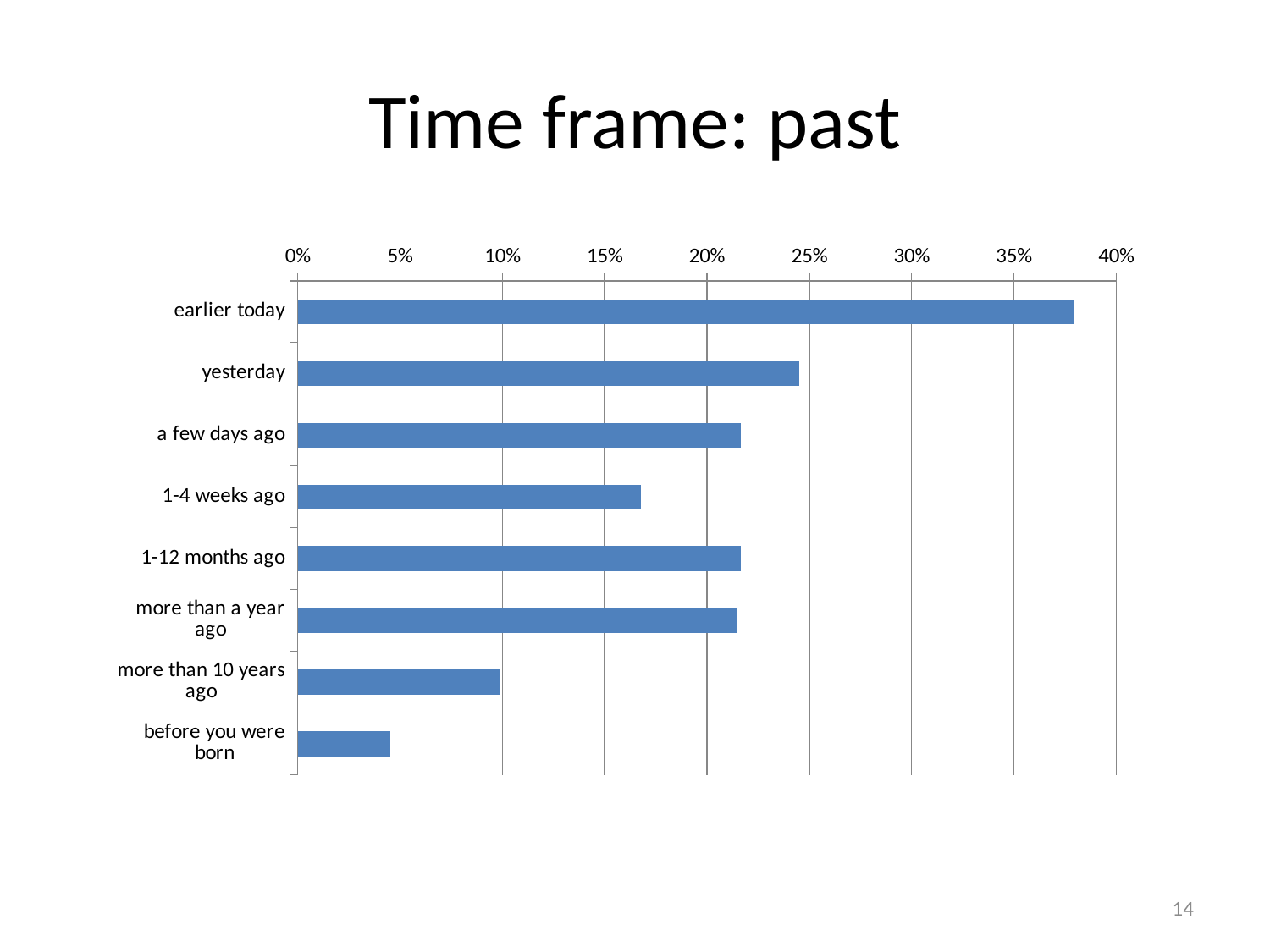
Is the value for 'earlier today' greater or less than 35%? greater Which has a larger value, 'a few days ago' or '1-4 weeks ago'? a few days ago Which category has the lowest value? before you were born Which has a larger value, 'earlier today' or 'yesterday'? earlier today Is the value for 'yesterday' greater or less than 25%? less Which category has the highest value? earlier today What kind of chart is shown on the slide? bar chart Is the value for '1-4 weeks ago' greater or less than 15%? greater What is the title of the slide containing the chart? Time frame: past How many categories are plotted in the chart? 8